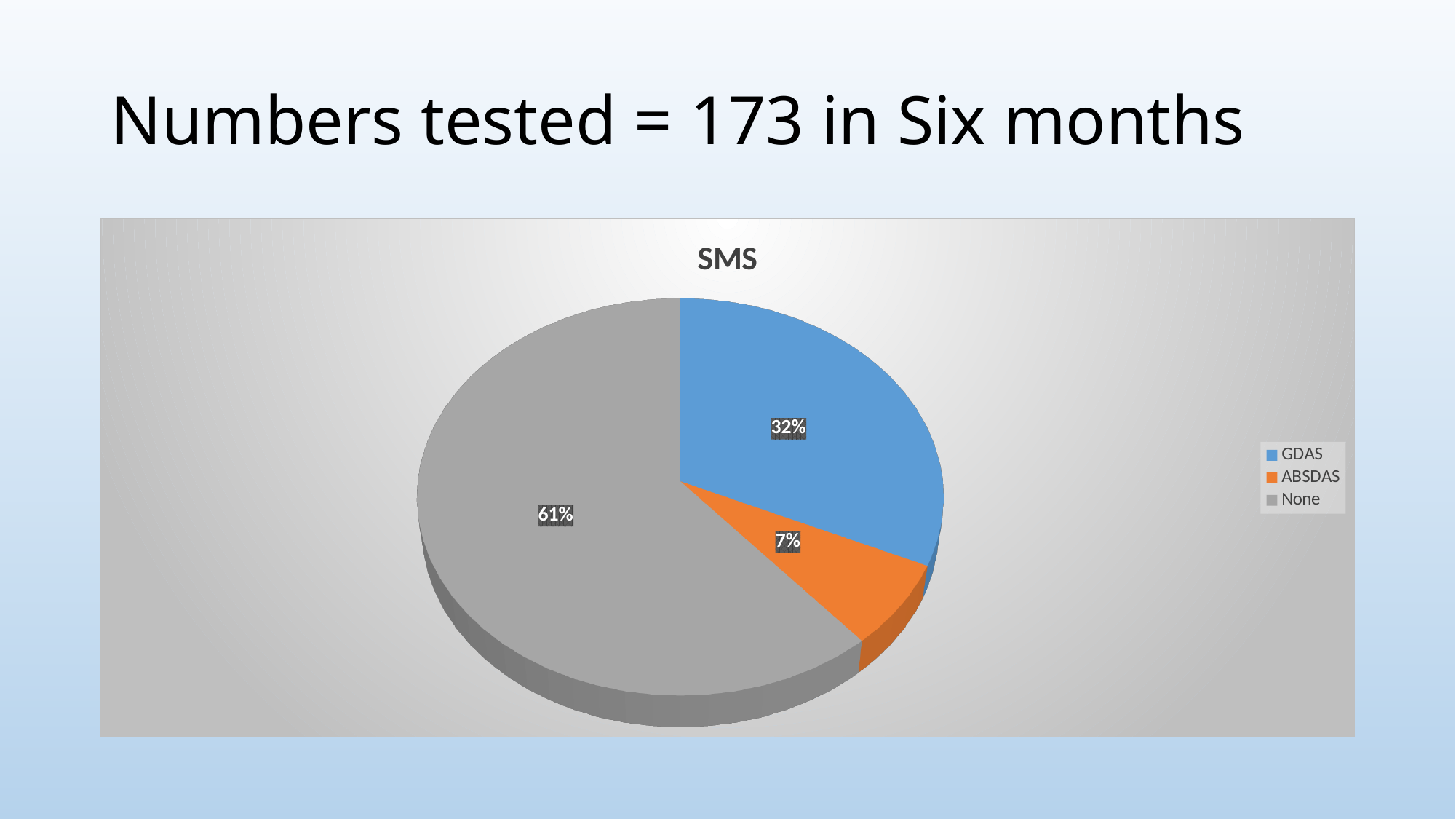
What share of the pie does ABSDAS represent? 7% What is the difference in percentage points between the GDAS slice and the ABSDAS slice? 25 What is the difference in percentage points between the None slice and the GDAS slice? 29 What kind of chart is shown on the slide? pie chart How many categories are shown in the pie chart? 3 What is the title of the chart? SMS Which is larger, the GDAS slice or the ABSDAS slice? GDAS What share of the pie does GDAS represent? 32% Which colour represents ABSDAS in the legend? orange Which category has the smallest slice of the pie? ABSDAS What share of the pie does None represent? 61% Which category has the largest slice of the pie? None